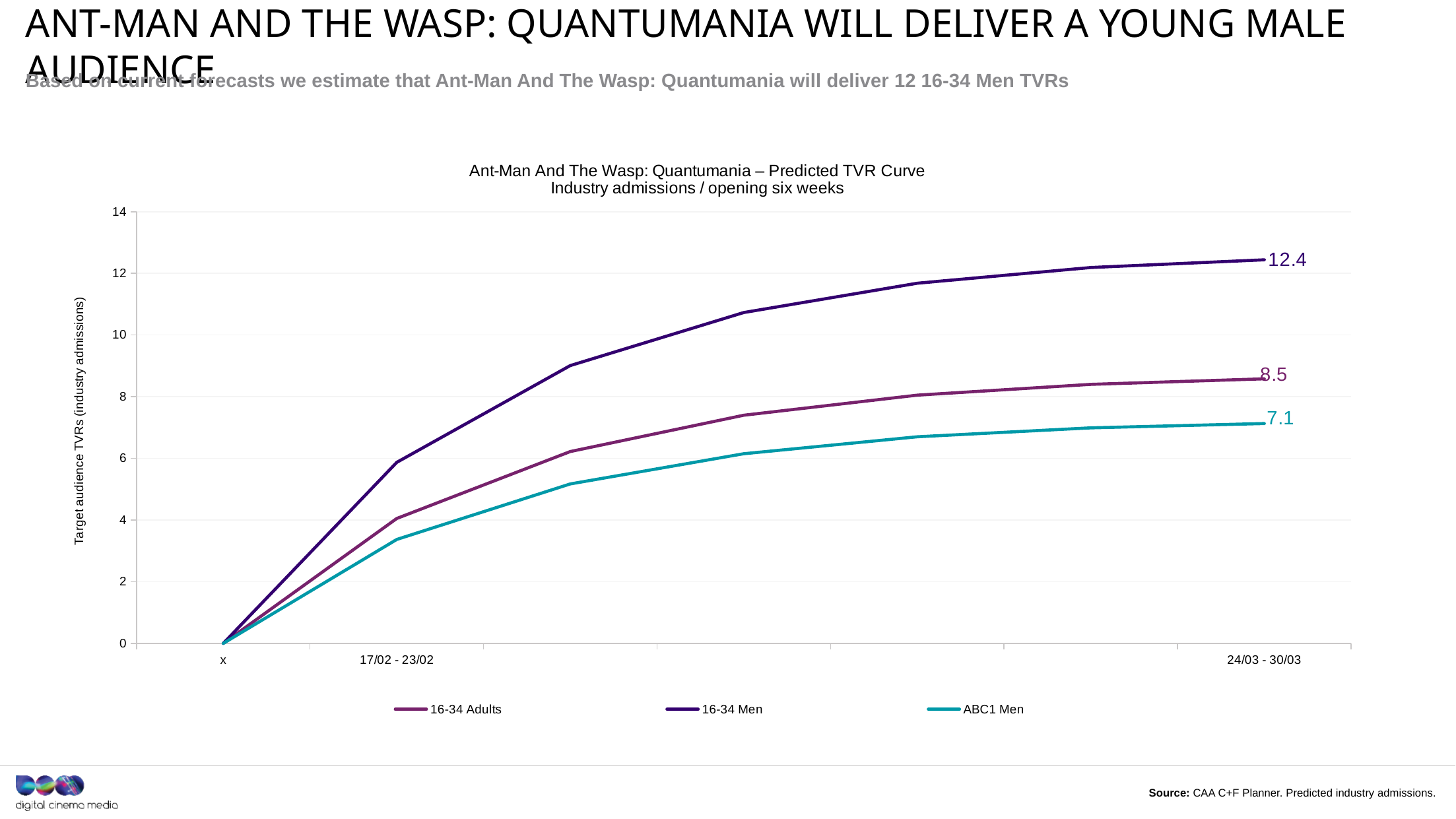
What is the final labelled value for the 16-34 Adults series? 8.5 Is the value for ABC1 Men at 17/02 - 23/02 greater or less than 4? less What is the final labelled value for the 16-34 Men series? 12.4 What is the final labelled value for the ABC1 Men series? 7.1 Which series has the lowest value at the end of the curve? ABC1 Men What kind of chart is shown on the slide? line chart Which series reaches the highest value at the end of the curve? 16-34 Men How many series does the legend list? 3 Do the values rise or fall along the x axis? rise What is the difference between the final values of 16-34 Adults and ABC1 Men? 1.4 What is the difference between the final values of 16-34 Men and 16-34 Adults? 3.9 At the end of the curve, which is larger: 16-34 Adults or ABC1 Men? 16-34 Adults